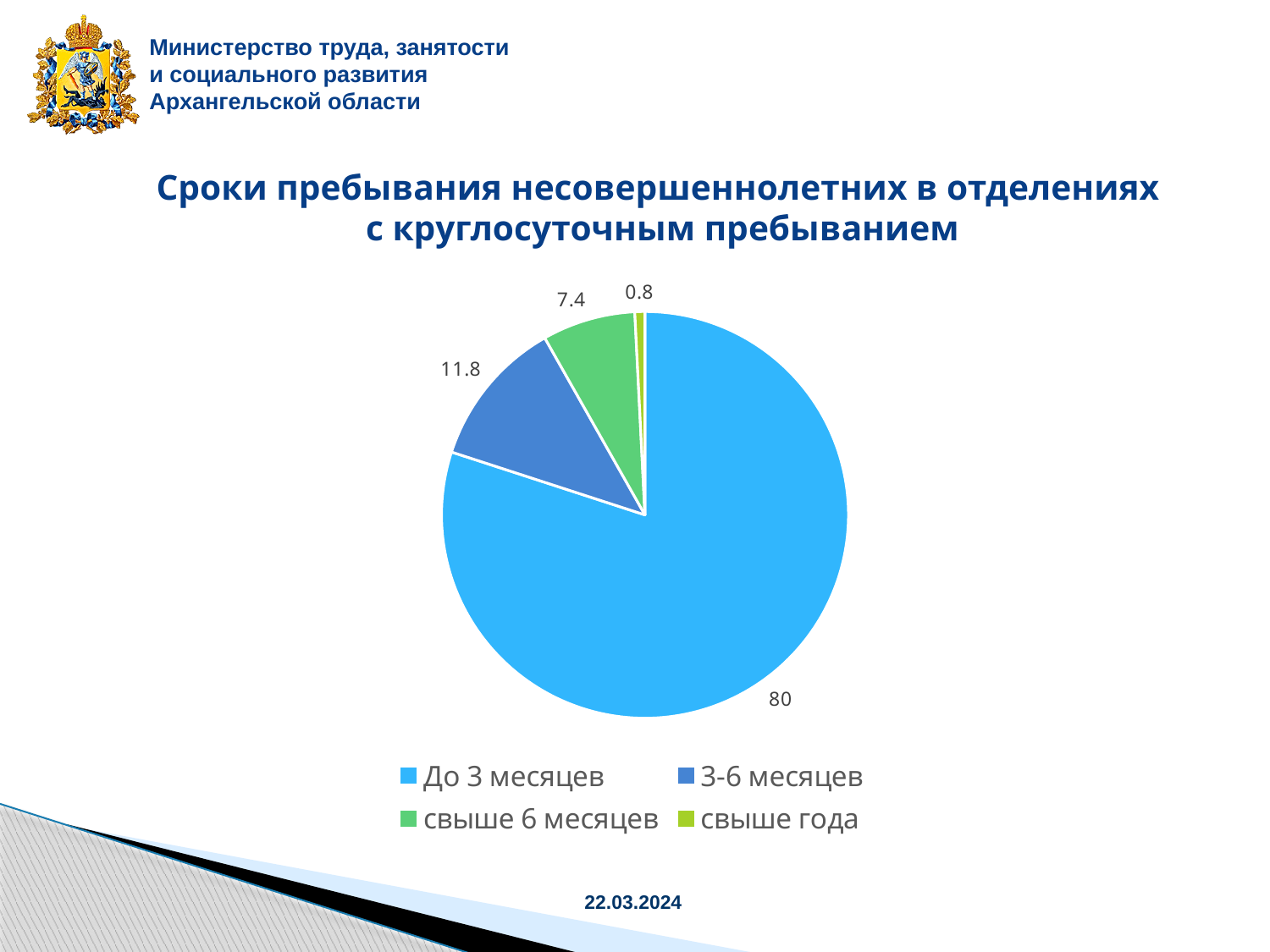
How many slices does the pie chart have? 4 How many entries does the legend list? 4 What is the title of the chart on the slide? Сроки пребывания несовершеннолетних в отделениях с круглосуточным пребыванием Which category has the smallest slice of the pie? свыше года What is the difference between the values for "3-6 месяцев" and "свыше 6 месяцев"? 4.4 What kind of chart is shown on the slide? pie chart What is the value for the slice "3-6 месяцев"? 11.8 What is the value for the slice "свыше 6 месяцев"? 7.4 What is the value for the slice "До 3 месяцев"? 80 Which is larger: the value for "свыше 6 месяцев" or the value for "свыше года"? свыше 6 месяцев Which category has the largest slice of the pie? До 3 месяцев What is the value for the slice "свыше года"? 0.8